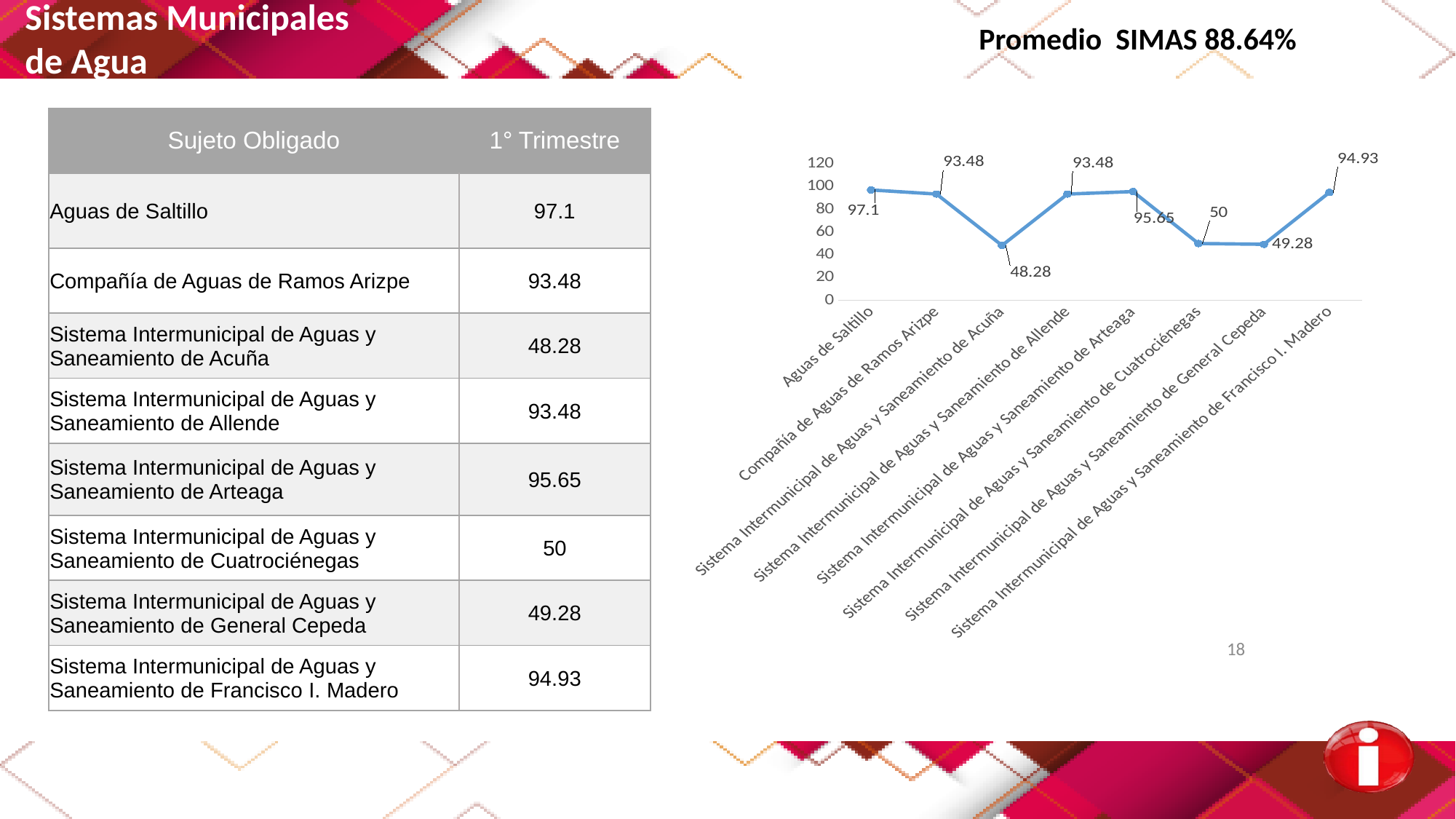
How many data points are plotted on the line chart? 8 What is the value plotted for Sistema Intermunicipal de Aguas y Saneamiento de Acuña? 48.28 What is the value plotted for Sistema Intermunicipal de Aguas y Saneamiento de General Cepeda? 49.28 Which is larger, the value for Sistema Intermunicipal de Aguas y Saneamiento de Cuatrociénegas or for Sistema Intermunicipal de Aguas y Saneamiento de Francisco I. Madero? Sistema Intermunicipal de Aguas y Saneamiento de Francisco I. Madero What is the highest tick value shown on the vertical axis of the line chart? 120 Which category has the lowest value on the line chart? Sistema Intermunicipal de Aguas y Saneamiento de Acuña Is the value for Sistema Intermunicipal de Aguas y Saneamiento de Allende greater or less than 80? greater Which category has the highest value on the line chart? Aguas de Saltillo What is the value plotted for Sistema Intermunicipal de Aguas y Saneamiento de Arteaga? 95.65 What type of chart is shown on the slide? Line chart What is the value plotted for Aguas de Saltillo? 97.1 What is the difference between the values for Aguas de Saltillo and Sistema Intermunicipal de Aguas y Saneamiento de Acuña? 48.82